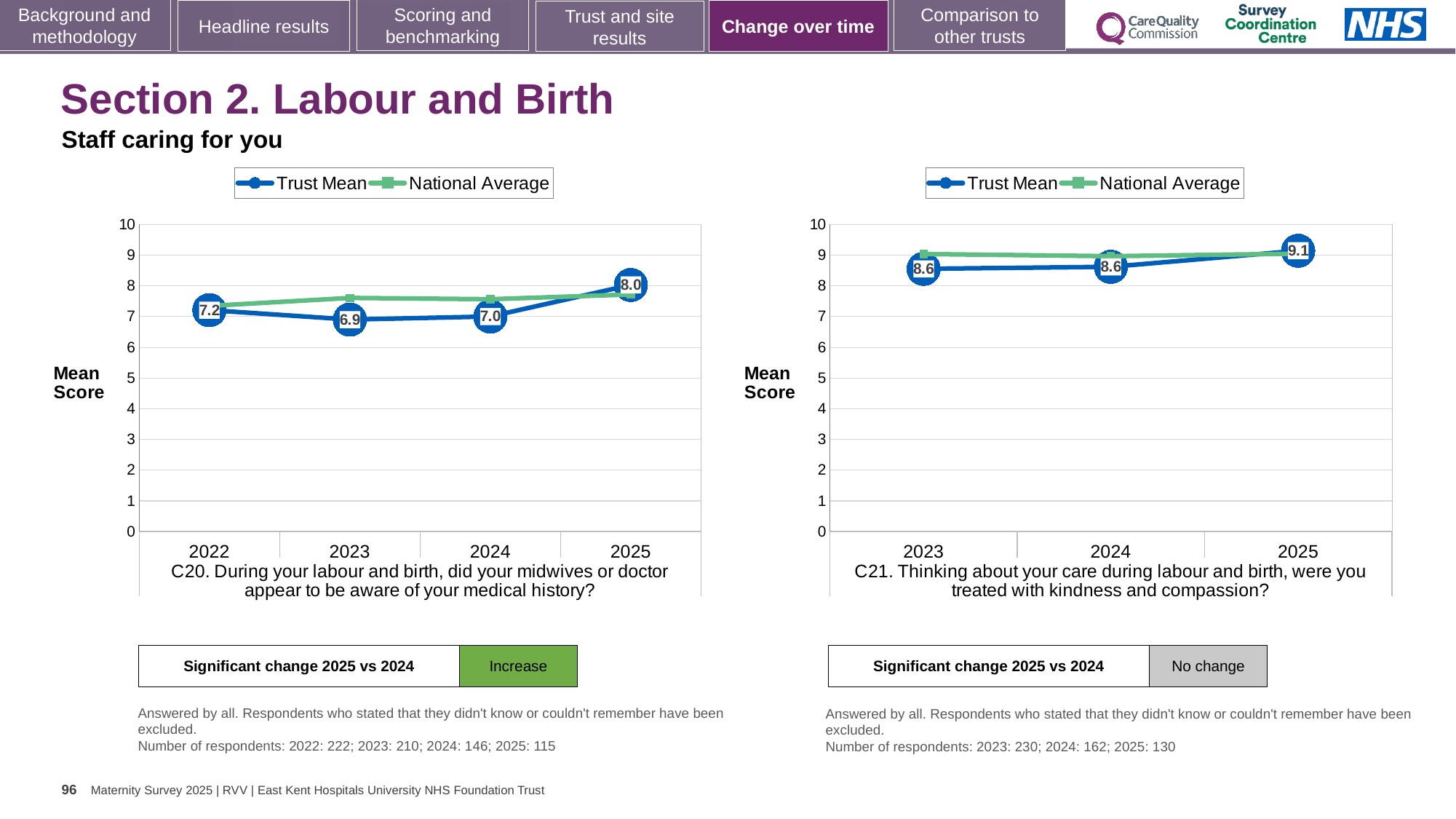
How many series does the legend of the C21 chart on the right list? 2 In the C21 chart on the right, does the Trust Mean rise or fall from 2024 to 2025? rise In the C20 chart on the left, what is the Trust Mean score for 2023? 6.9 In the C21 chart on the right, what is the difference between the Trust Mean scores for 2025 and 2023? 0.5 In the C20 chart on the left, what is the Trust Mean score for 2025? 8.0 In the C20 chart on the left, is the Trust Mean score higher in 2022 or in 2023? 2022 In the C20 chart on the left, which year has the highest Trust Mean score? 2025 In the C20 chart on the left, is the National Average value for 2023 greater or less than 7? greater In the C20 chart on the left, which year has the lowest Trust Mean score? 2023 How many years are shown on the x axis of the C20 chart on the left? 4 In the C20 chart on the left, what is the difference between the Trust Mean scores for 2025 and 2024? 1.0 In the C21 chart on the right, what is the Trust Mean score for 2025? 9.1